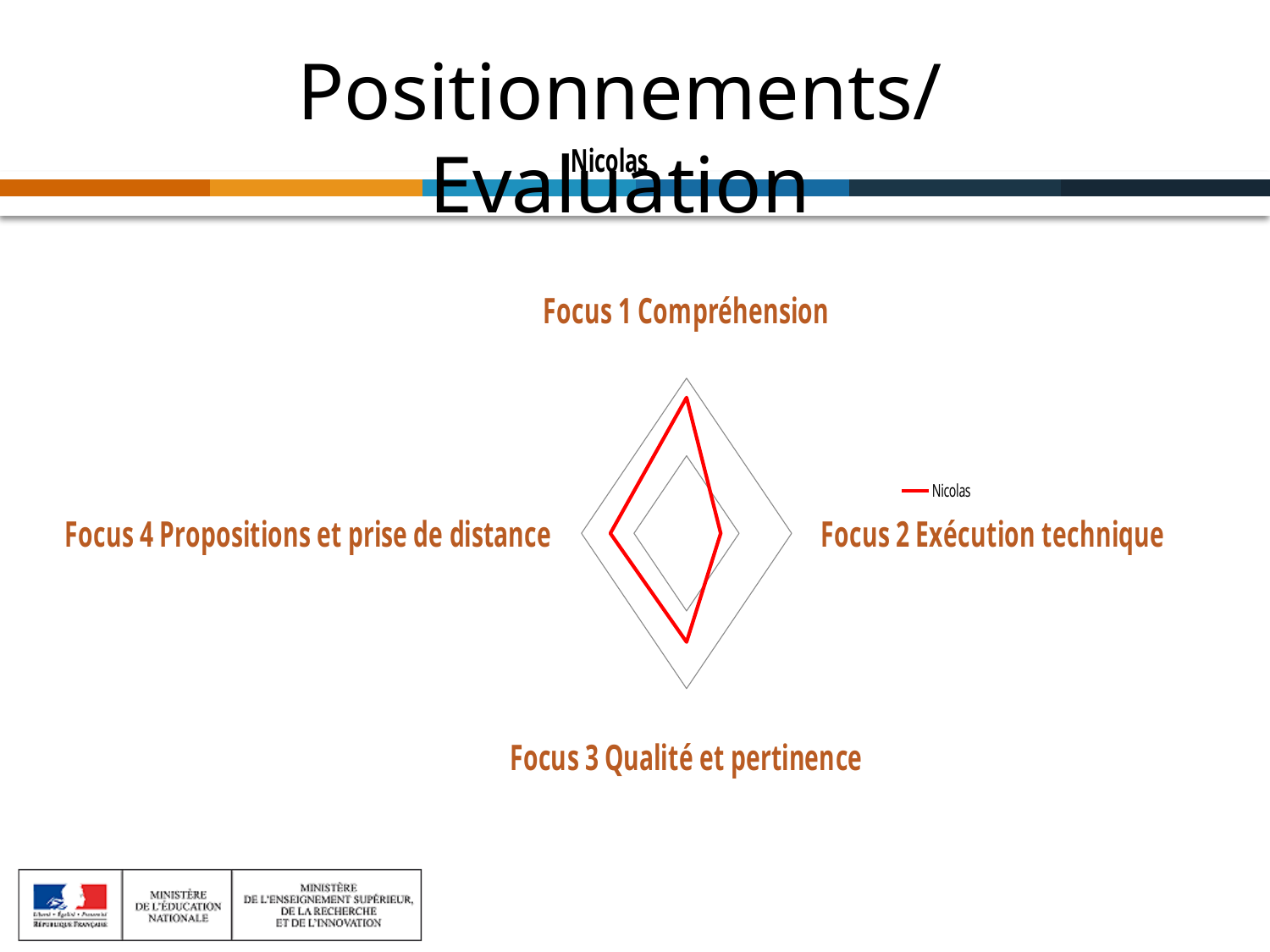
Which category has the highest value on the radar chart? Focus 1 Compréhension Which is larger on the radar chart: the value for Focus 3 Qualité et pertinence or for Focus 2 Exécution technique? Focus 3 Qualité et pertinence What colour is the line plotted for Nicolas on the radar chart? Red How many series does the legend of the radar chart list? 1 Which category label appears at the bottom of the radar chart? Focus 3 Qualité et pertinence Which category has the lowest value on the radar chart? Focus 2 Exécution technique What kind of chart is shown on the slide? Radar chart What is the name of the series shown in the legend of the radar chart? Nicolas Which is larger on the radar chart: the value for Focus 1 Compréhension or for Focus 2 Exécution technique? Focus 1 Compréhension How many categories (axes) does the radar chart have? 4 Which is larger on the radar chart: the value for Focus 1 Compréhension or for Focus 3 Qualité et pertinence? Focus 1 Compréhension